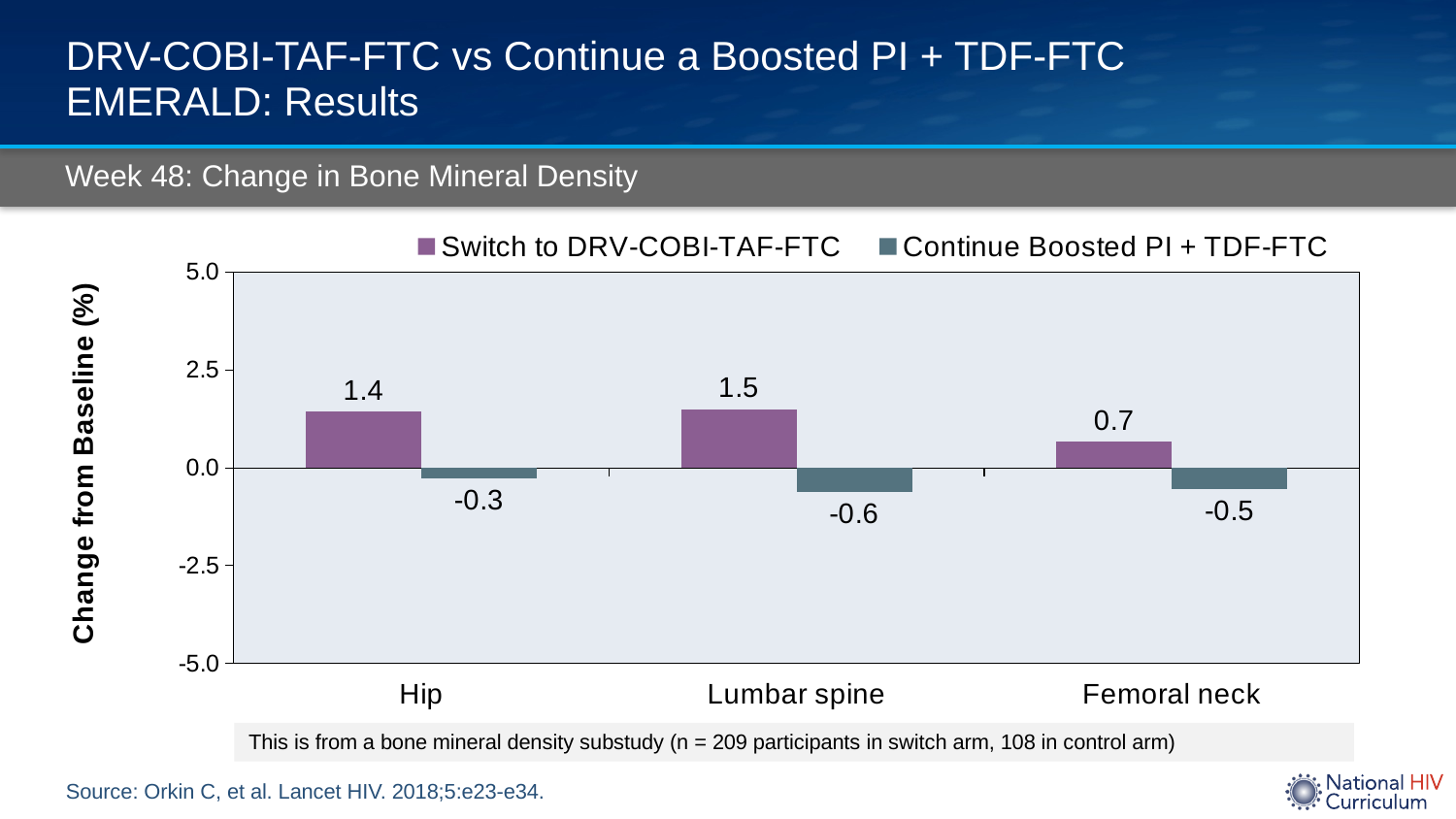
How many series does the legend list? 2 What is the change from baseline for Hip in the Switch to DRV-COBI-TAF-FTC group? 1.4 What kind of chart is shown on the slide? Bar chart Which category has the highest value for the Switch to DRV-COBI-TAF-FTC group? Lumbar spine What is the change from baseline for Lumbar spine in the Continue Boosted PI + TDF-FTC group? -0.6 What is the difference between the Switch and Continue groups for Lumbar spine? 2.1 Which is larger for Femoral neck: the Switch to DRV-COBI-TAF-FTC value or the Continue Boosted PI + TDF-FTC value? Switch to DRV-COBI-TAF-FTC What is the label of the y axis? Change from Baseline (%) What is the change from baseline for Hip in the Continue Boosted PI + TDF-FTC group? -0.3 What is the change from baseline for Femoral neck in the Switch to DRV-COBI-TAF-FTC group? 0.7 How many categories are shown on the x axis? 3 Which category has the lowest value for the Continue Boosted PI + TDF-FTC group? Lumbar spine